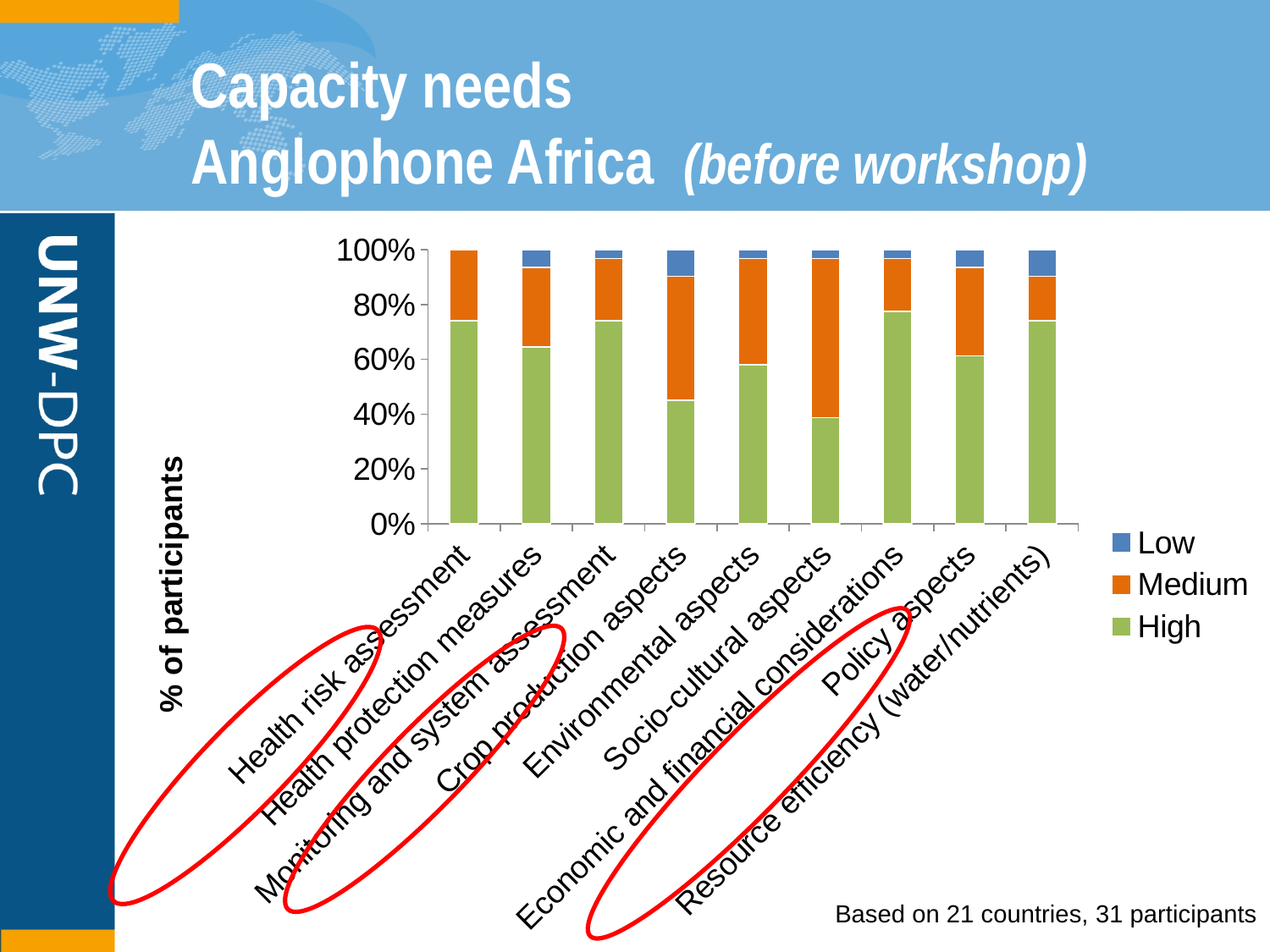
Is the High value for Crop production aspects greater or less than 60%? less How many series does the chart's legend list? 3 Which category has the lowest share of participants rating the need as High? Socio-cultural aspects What kind of chart is shown on the slide? Stacked bar chart Which category has the largest Medium segment? Socio-cultural aspects What are the three series listed in the chart's legend? Low, Medium, High What do the stacked segments of each bar add up to? 100% How many categories are plotted along the x axis of the chart? 9 Is the High value for Health risk assessment greater or less than 60%? greater What is the label on the vertical axis of the chart? % of participants Which category shows no Low segment at all? Health risk assessment